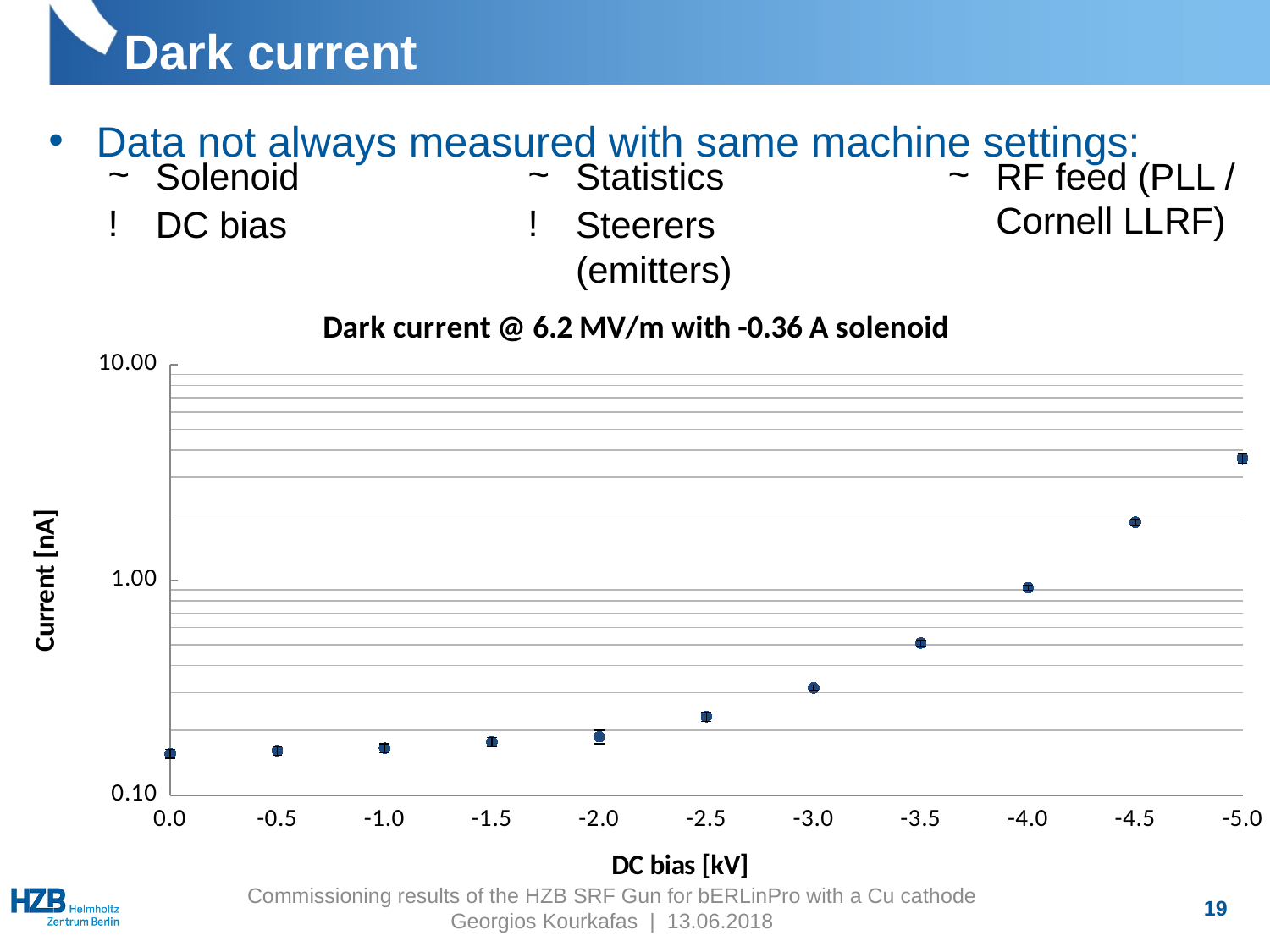
Is the current at a DC bias of -3.0 kV greater or less than 1.00 nA? less What is the title of the chart? Dark current @ 6.2 MV/m with -0.36 A solenoid What kind of chart is shown on the slide? scatter chart At which DC bias value is the current highest? -5.0 Is the current at a DC bias of -5.0 kV greater or less than 1.00 nA? greater How many data points are plotted in the chart? 11 Does the current rise or fall as the DC bias goes from 0.0 to -5.0 kV along the x axis? rise What is the label of the y axis? Current [nA] Which has a larger current: the point at -3.5 kV or the point at -2.0 kV? -3.5 kV Is the current at a DC bias of 0.0 kV greater or less than 1.00 nA? less Which has a larger current: the point at -5.0 kV or the point at -4.5 kV? -5.0 kV